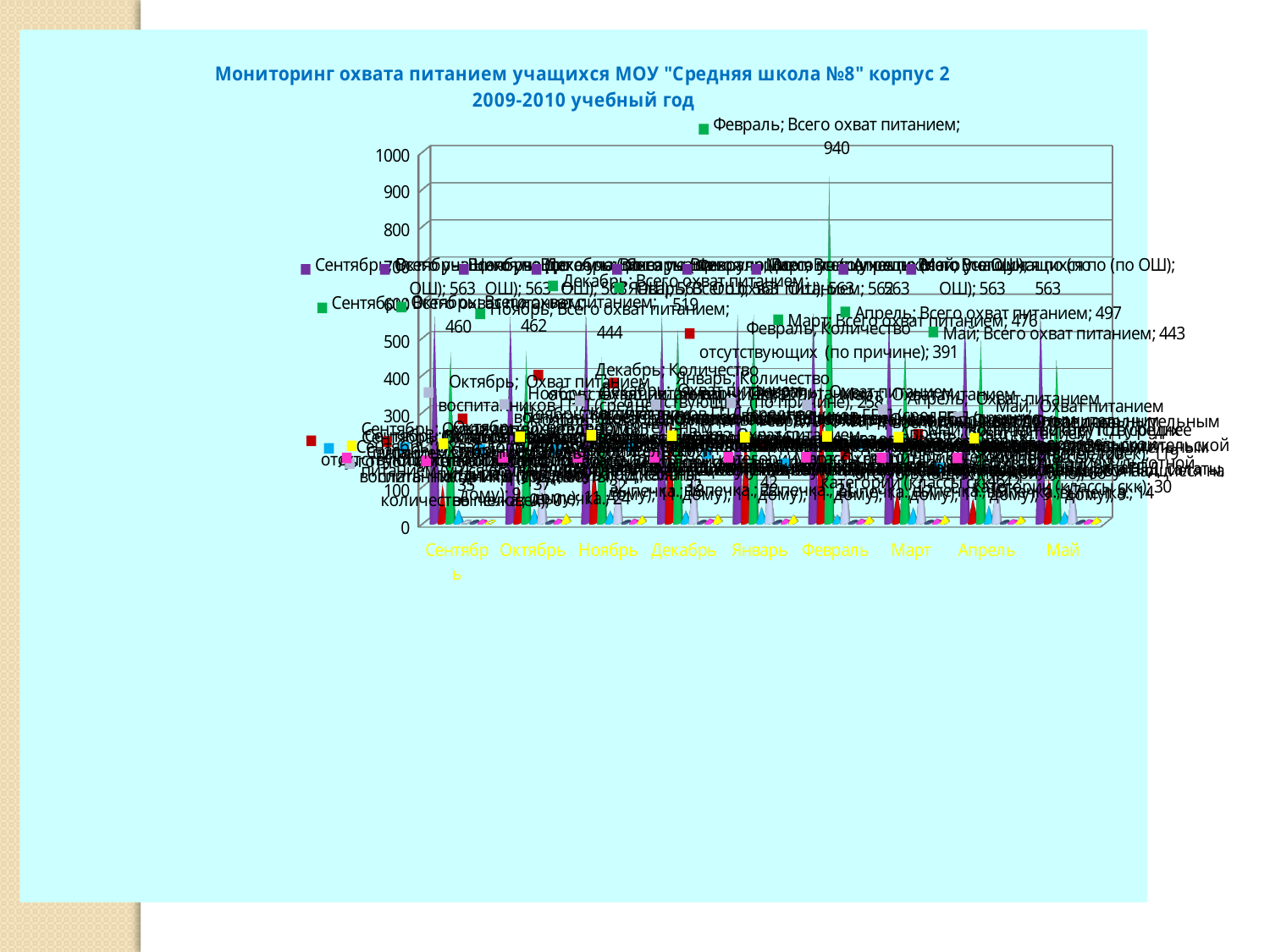
What is the highest value shown on the y axis of the chart? 1000 Which is larger, the "Всего охват питанием" value for Декабрь or for Март? Декабрь How many months are shown on the x axis of the chart? 9 Is the "Всего охват питанием" value for Февраль greater or less than 900? greater What is the title of the chart? Мониторинг охвата питанием учащихся МОУ "Средняя школа №8" корпус 2 2009-2010 учебный год What is the value of "Всего охват питанием" for Февраль? 940 What is the value of "Всего охват питанием" for Сентябрь? 460 What is the difference between the "Всего охват питанием" values for Февраль and Сентябрь? 480 What is the value of "Всего охват питанием" for Декабрь? 519 Which month has the highest value of "Всего охват питанием"? Февраль What is the value of "Всего охват питанием" for Апрель? 497 What is the value of "Количество отсутствующих (по причине)" for Февраль? 391